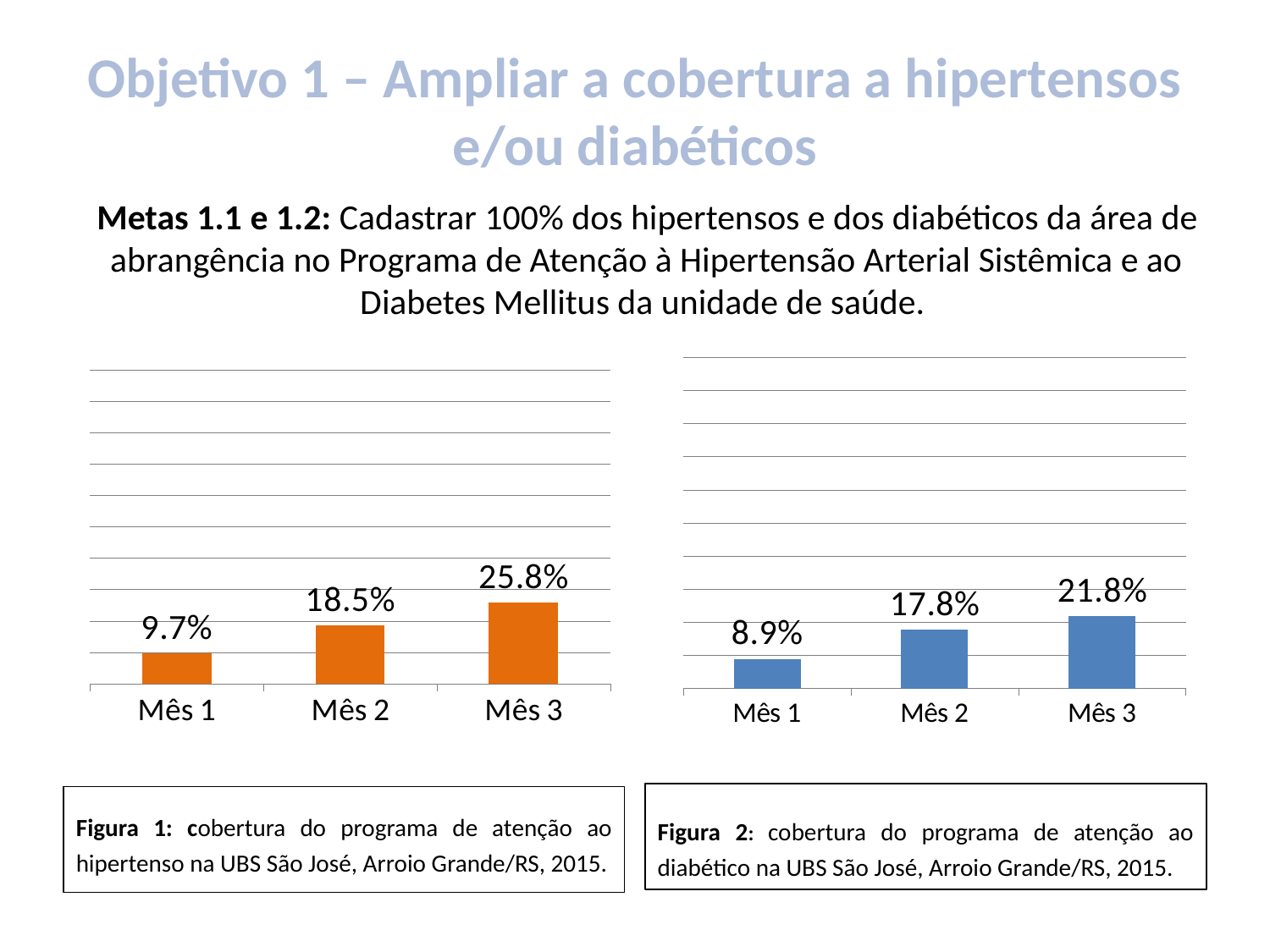
How many months (categories) are shown in the left chart (Figura 1)? 3 In the right chart (Figura 2, diabetes coverage), what is the value for Mês 3? 21.8% In the right chart (Figura 2), what is the difference between the values for Mês 2 and Mês 1? 8.9% What colour are the bars in the left chart (Figura 1)? Orange In the left chart (Figura 1, hypertension coverage), what is the value for Mês 2? 18.5% Which is larger: the Mês 3 value in the left chart (Figura 1) or the Mês 3 value in the right chart (Figura 2)? Left chart (Figura 1), 25.8% In the right chart (Figura 2), do the values rise or fall from Mês 1 to Mês 3? Rise In the right chart (Figura 2), which month has the lowest coverage? Mês 1 In the left chart (Figura 1), what is the difference between the values for Mês 3 and Mês 1? 16.1% In the left chart (Figura 1), which month has the highest coverage? Mês 3 What type of chart is the right chart (Figura 2)? Bar chart In the left chart (Figura 1), what is the value for Mês 1? 9.7%